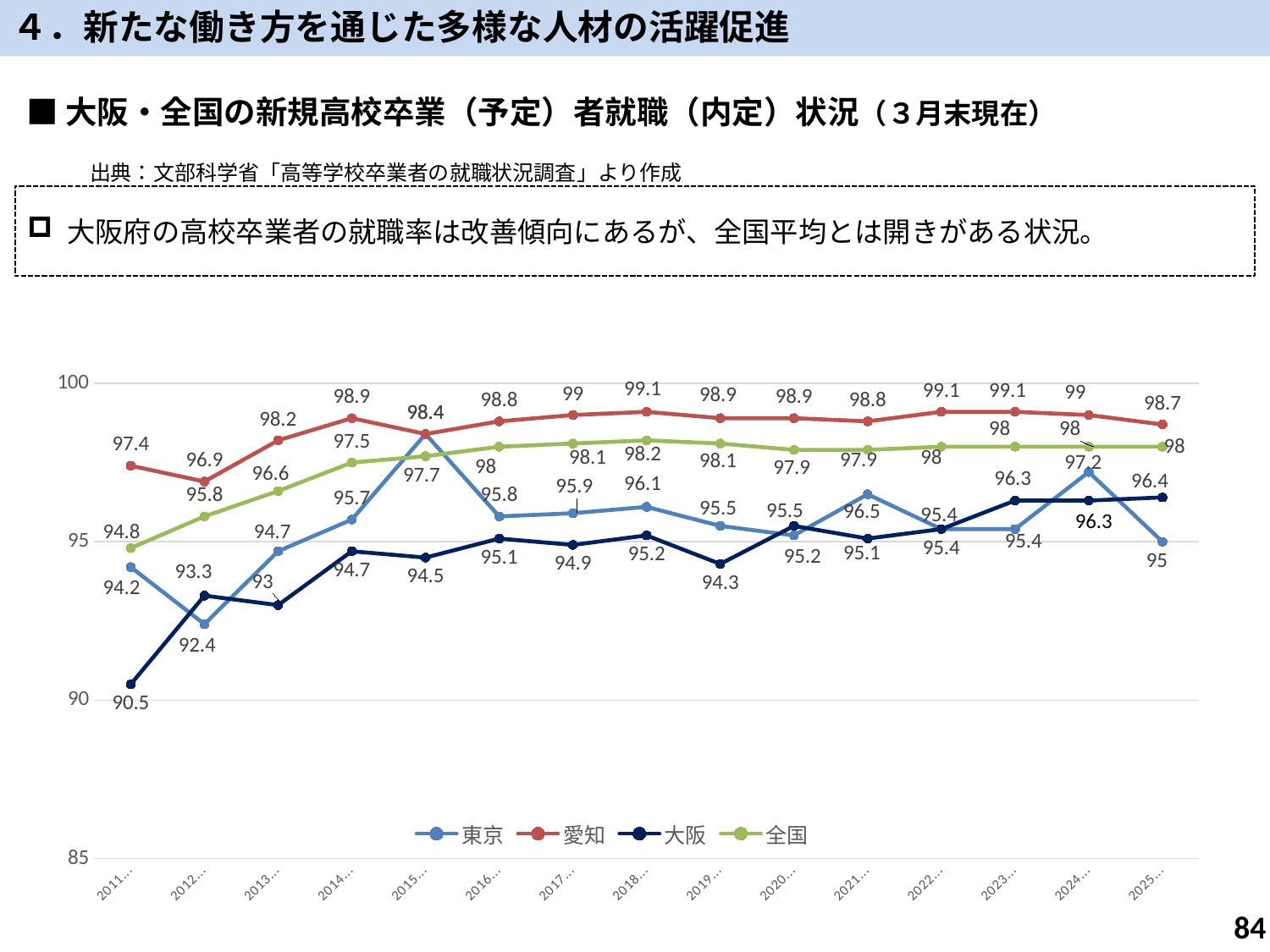
What kind of chart is shown on the slide? line chart What is the highest value reached by the 愛知 series? 99.1 What is the value for 全国 at the first point (2011)? 94.8 How many points (years) are plotted along the x axis? 15 Which series are listed in the legend? 東京, 愛知, 大阪, 全国 At which year does the 大阪 series have its lowest value? 2011 At 2012, which is larger: the value for 東京 or the value for 大阪? 大阪 Does the 大阪 series rise or fall overall from 2011 to 2025? rise What is the value for 大阪 at the first point (2011)? 90.5 How many series does the legend list? 4 What is the value for 大阪 at the last point (2025)? 96.4 What is the difference between 全国 and 大阪 at the last point (2025)? 1.6